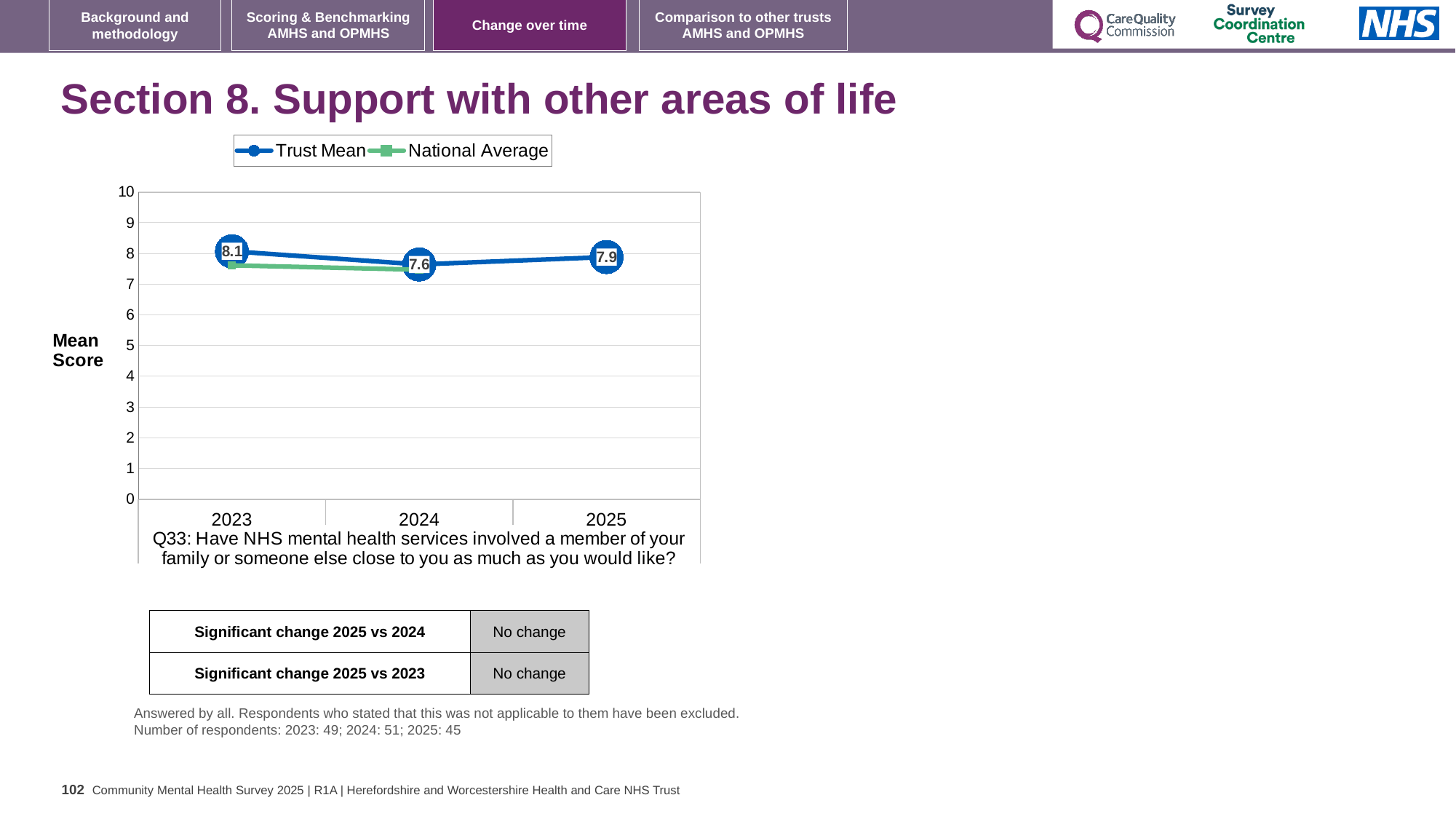
In which year is the Trust Mean highest? 2023 What is the label on the y axis of the chart? Mean Score What is the difference between the Trust Mean in 2023 and in 2024? 0.5 Which is larger, the Trust Mean in 2023 or in 2025? 2023 What is the Trust Mean score for 2024? 7.6 How many years are shown on the x axis of the chart? 3 What is the Trust Mean score for 2025? 7.9 Is the National Average value for 2023 greater or less than 8? less What is the Trust Mean score for 2023? 8.1 What kind of chart is shown on the slide? Line chart In which year is the Trust Mean lowest? 2024 How many series does the chart legend list? 2